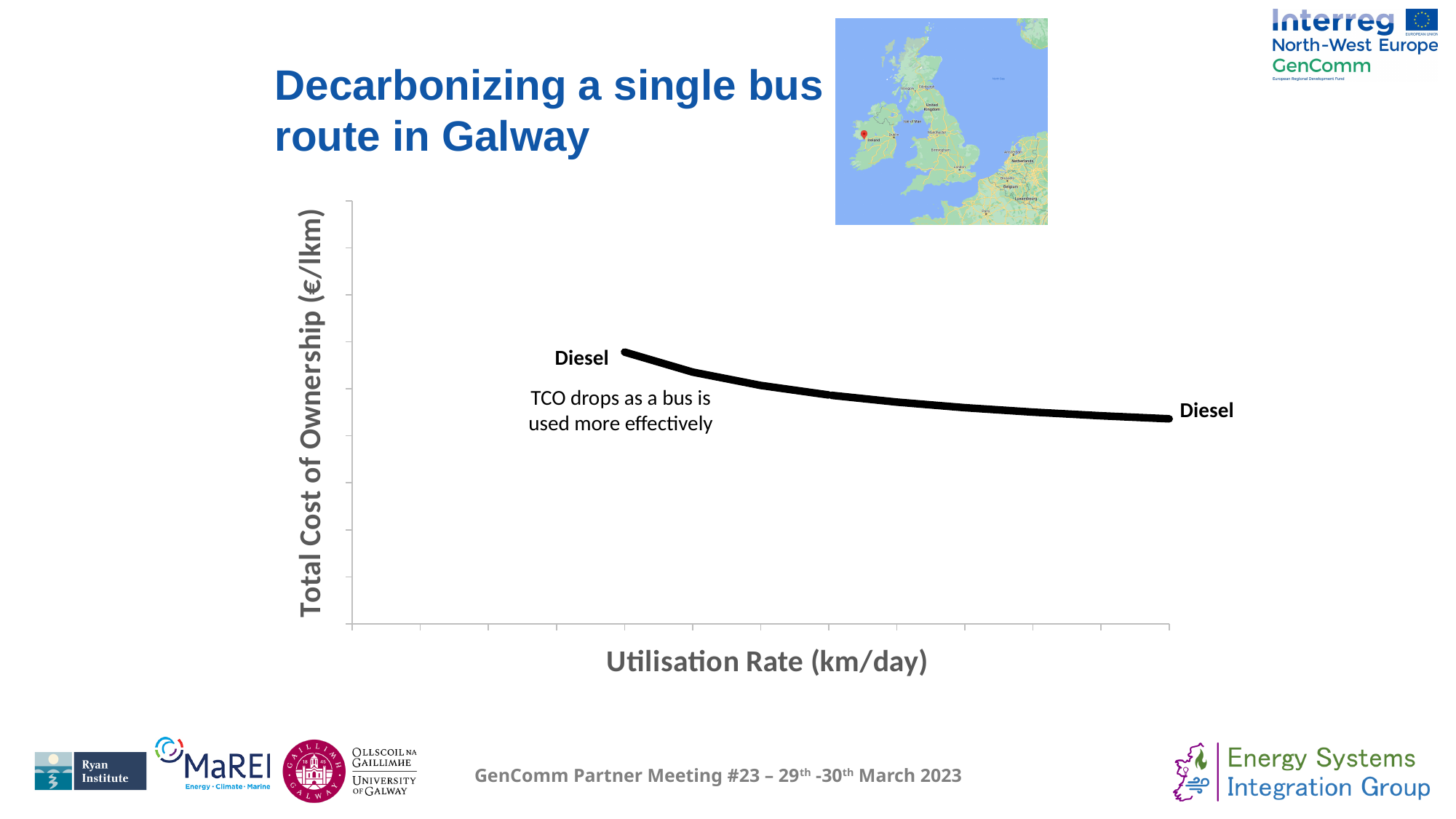
What is the label of the line plotted on the chart? Diesel How many lines (series) are plotted on the chart? 1 Is the Diesel total cost of ownership higher at the left end or the right end of the line? left end What is the title of the y axis of the chart? Total Cost of Ownership (€/lkm) Does the Diesel line rise or fall as the utilisation rate increases along the x axis? fall What kind of chart is shown on the slide? line chart